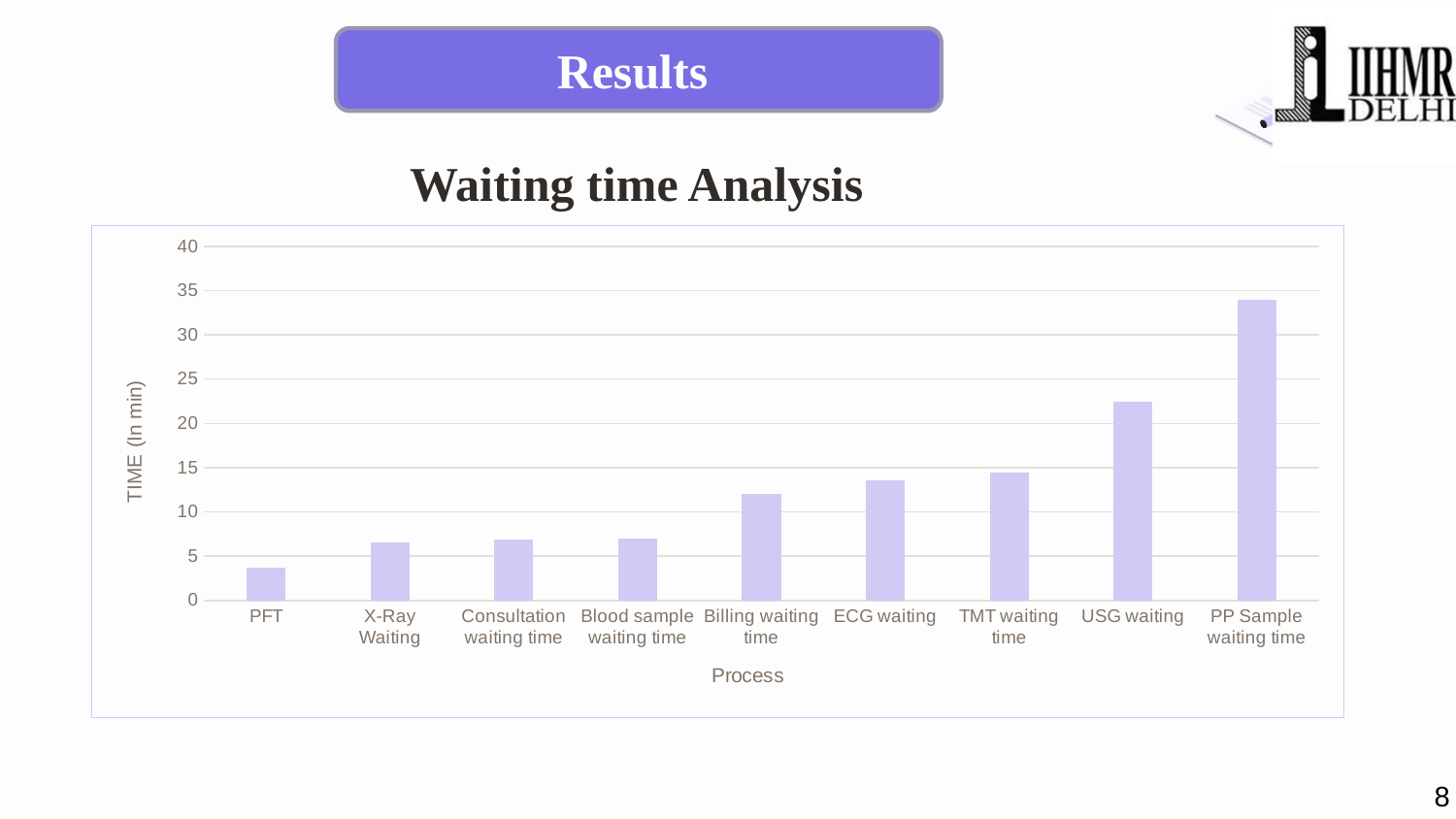
Is the value for PFT greater or less than 5? less What kind of chart is shown on the slide? bar chart Which process has the highest waiting time? PP Sample waiting time Is the value for ECG waiting greater or less than 15? less Which process has the lowest waiting time? PFT Which has a larger waiting time, USG waiting or ECG waiting? USG waiting Is the value for PP Sample waiting time greater or less than 30? greater How many processes are plotted on the chart? 9 Do the waiting times rise or fall moving from left to right along the x axis? rise What is the title of the y axis? TIME (In min)